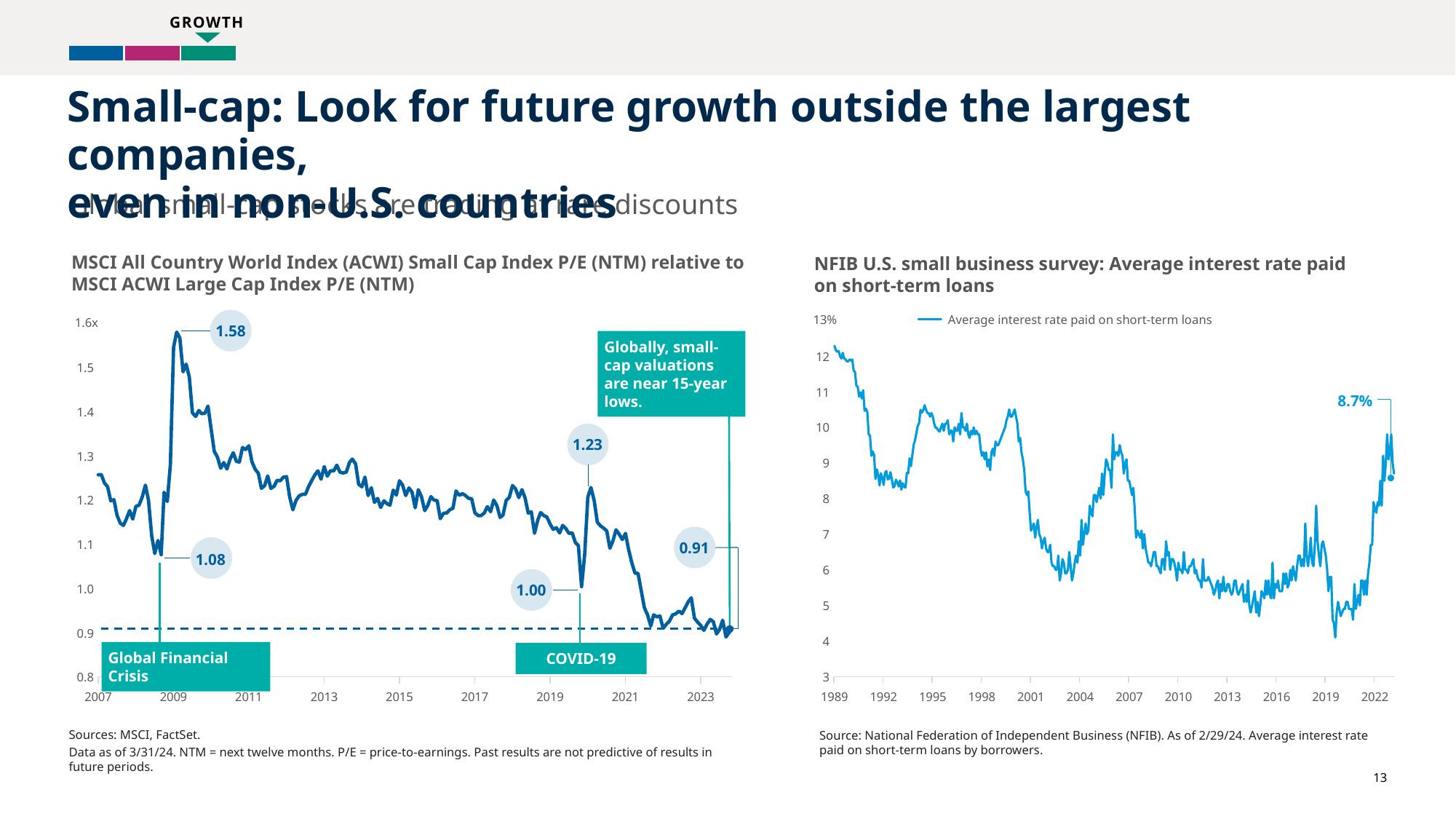
In the left chart (MSCI ACWI Small Cap relative P/E), what is the peak value labeled around 2009? 1.58 In the left chart (MSCI ACWI Small Cap relative P/E), what is the most recent labeled value at the end of the series? 0.91 In the right chart (NFIB average interest rate paid on short-term loans), what is the labeled value at the end of the series? 8.7% In the left chart (MSCI ACWI Small Cap relative P/E), what value is labeled at the Global Financial Crisis low? 1.08 In the left chart (MSCI ACWI Small Cap relative P/E), which labeled value is larger: the 2009 peak or the post-COVID peak? the 2009 peak (1.58) How many series does the legend list in the right chart (NFIB average interest rate paid on short-term loans)? 1 In the left chart (MSCI ACWI Small Cap relative P/E), what is the overall trend of the ratio from 2009 to 2023? falling In the left chart (MSCI ACWI Small Cap relative P/E), what is the difference between the 1.58 peak and the 0.91 ending value? 0.67 What is the text in the callout box on the left chart (MSCI ACWI Small Cap relative P/E)? Globally, small-cap valuations are near 15-year lows. In the left chart (MSCI ACWI Small Cap relative P/E), what value is labeled at the COVID-19 low? 1.00 What type of chart is the MSCI ACWI Small Cap relative P/E chart on the left? line chart